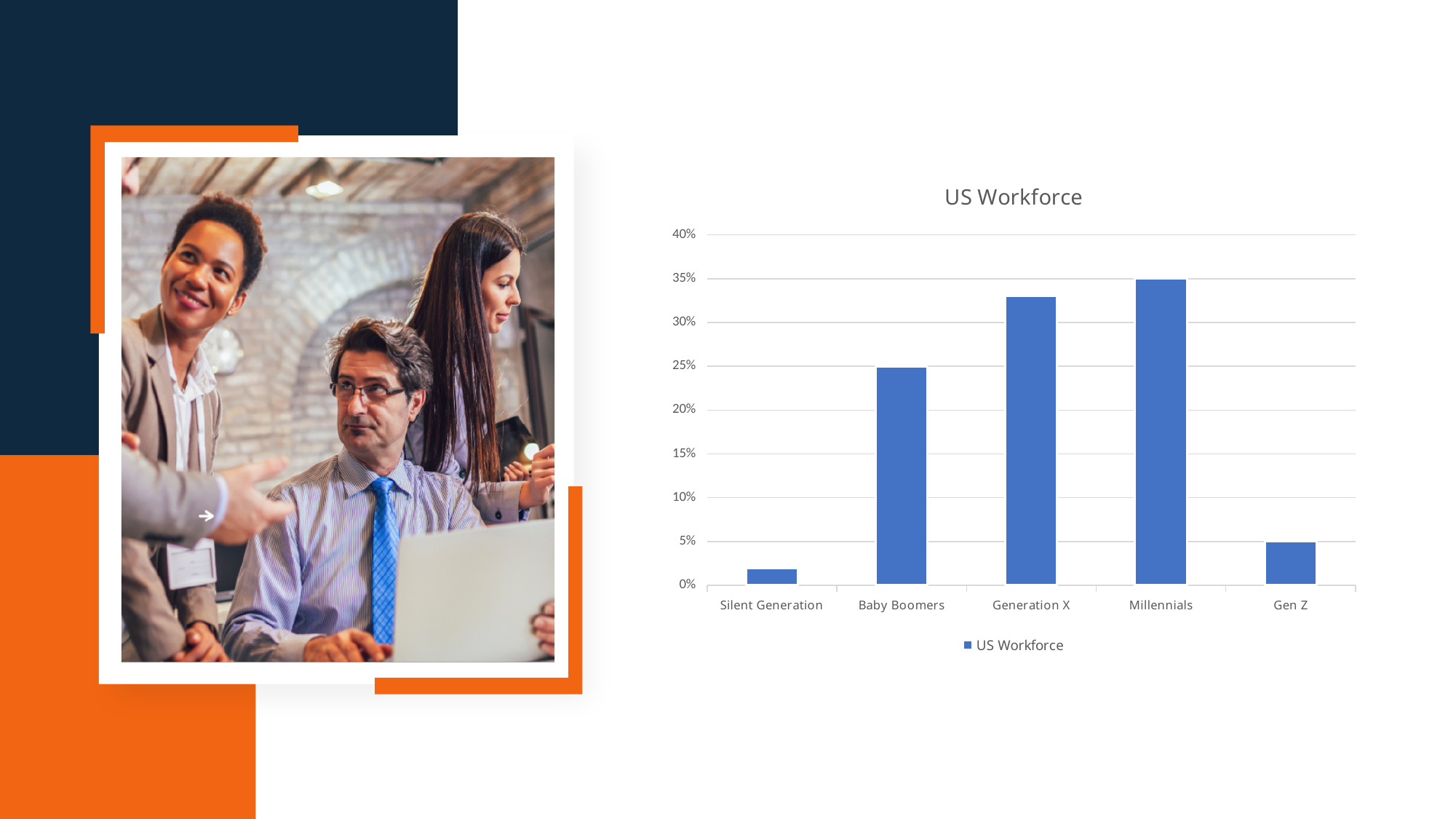
How many generation categories are shown on the x axis of the chart? 5 Which is larger, the value for Gen Z or the value for Silent Generation? Gen Z Is the value for Generation X greater or less than 30%? greater Is the value for Silent Generation greater or less than 5%? less Which generation has the highest share of the US workforce in the chart? Millennials What type of chart is shown on the slide? bar chart Is the value for Baby Boomers greater or less than 20%? greater What is the title of the chart? US Workforce Which is larger, the value for Baby Boomers or the value for Generation X? Generation X How many series does the chart's legend list? 1 Which generation has the lowest share of the US workforce in the chart? Silent Generation